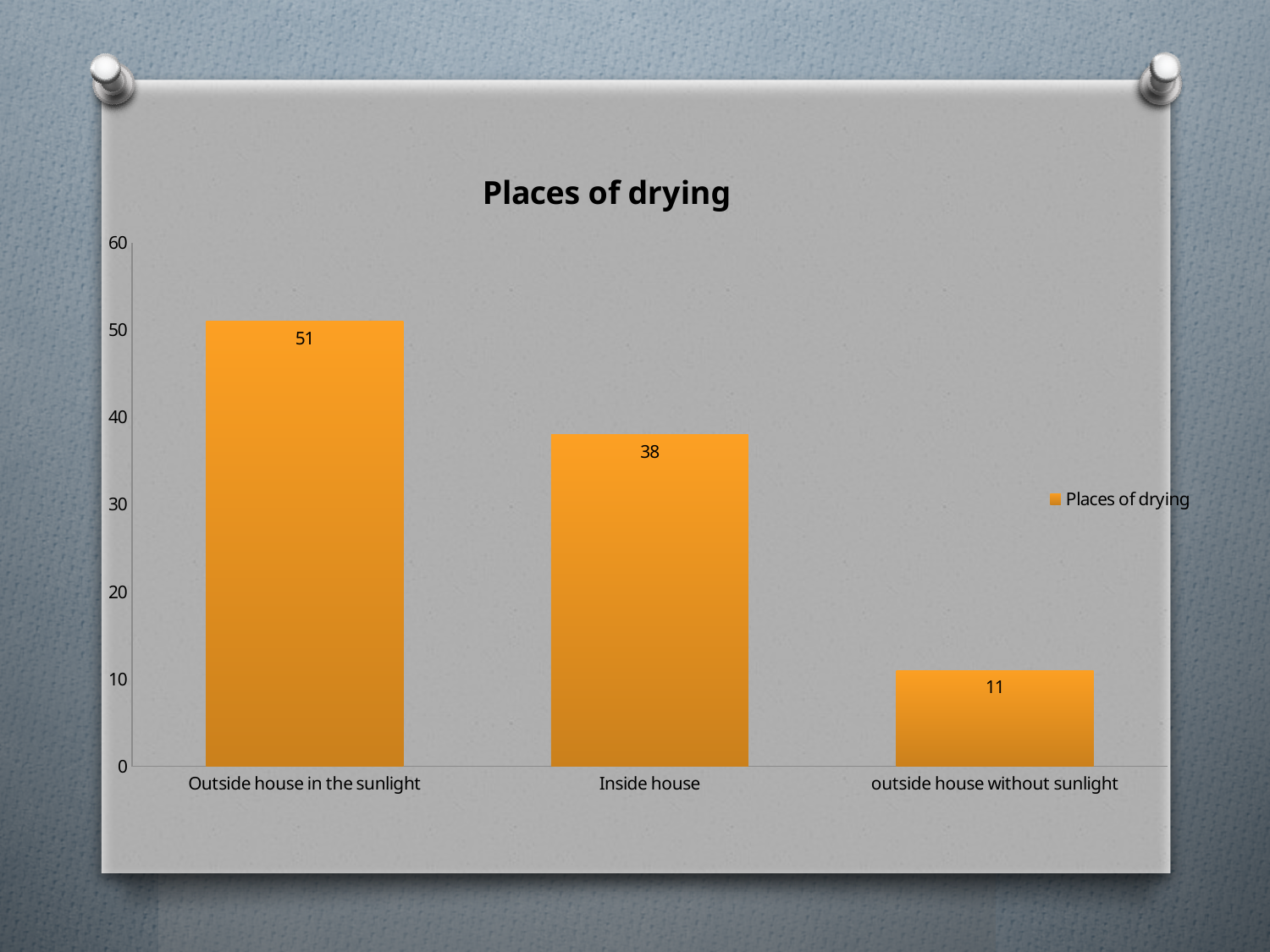
Which category has the highest value? Outside house in the sunlight What kind of chart is shown on the slide? bar chart Which is larger, the value for Inside house or the value for outside house without sunlight? Inside house What is the value for Inside house? 38 What is the difference between the values for Inside house and outside house without sunlight? 27 How many categories are shown on the x axis? 3 What is the value for Outside house in the sunlight? 51 Is the value for Inside house greater or less than 40? less Which category has the lowest value? outside house without sunlight What is the difference between the values for Outside house in the sunlight and Inside house? 13 What is the value for outside house without sunlight? 11 What is the title of the chart? Places of drying